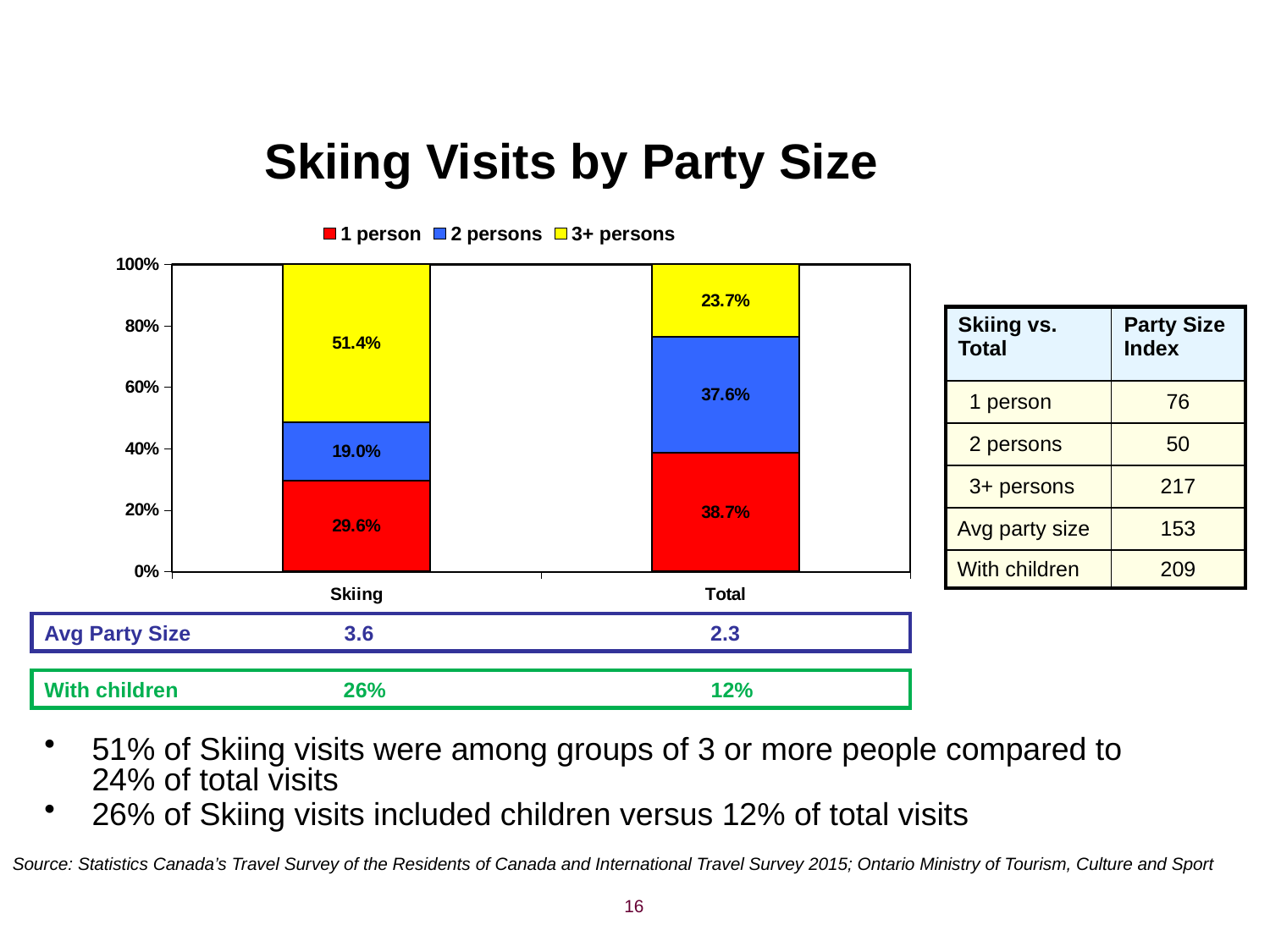
Which party size segment is the smallest for Total visits? 3+ persons What share of Total visits were by 1 person? 38.7% What is the difference between the 3+ persons share for Skiing and for Total? 27.7 percentage points Which is larger: the 2 persons share for Skiing or for Total? Total Which colour represents the 2 persons series? Blue What share of Total visits were by parties of 3+ persons? 23.7% How many series does the legend list? 3 Is the 1 person share for Skiing greater or less than 40%? less Which party size segment is the largest for Skiing visits? 3+ persons What share of Skiing visits were by parties of 2 persons? 19.0% What type of chart is shown? Stacked bar chart What share of Skiing visits were by parties of 3+ persons? 51.4%